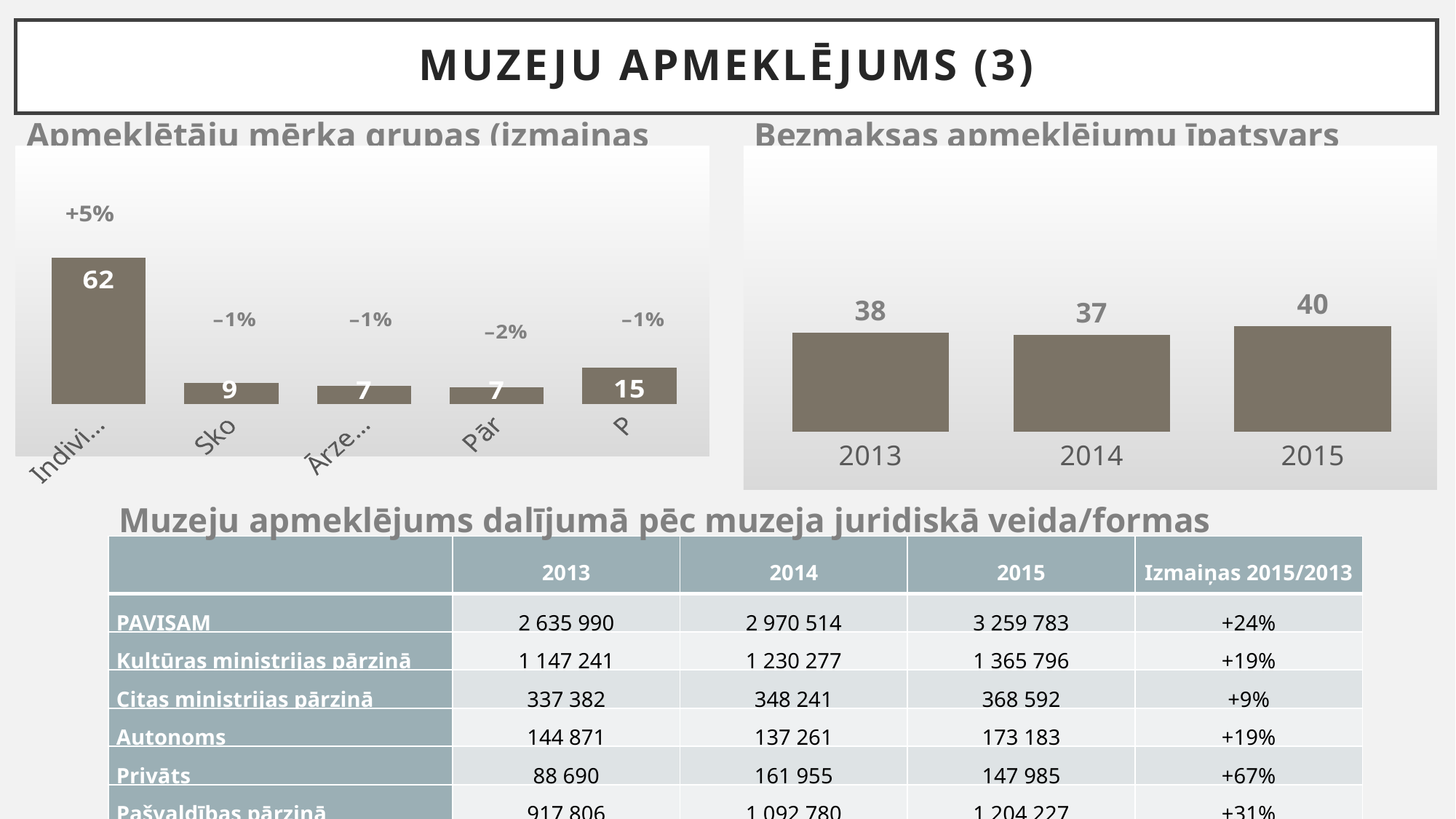
In the right-hand chart (Bezmaksas apmeklējumu īpatsvars), how many years are plotted? 3 In the right-hand chart (Bezmaksas apmeklējumu īpatsvars), what is the difference between the values for 2015 and 2013? 2 In the left-hand chart (Apmeklētāju mērķa grupas), what is the value of the rightmost bar? 15 In the right-hand chart (Bezmaksas apmeklējumu īpatsvars), which year has the lowest value? 2014 In the left-hand chart (Apmeklētāju mērķa grupas), what percentage change is printed above the tallest bar? +5% In the right-hand chart (Bezmaksas apmeklējumu īpatsvars), which year has the highest value? 2015 In the left-hand chart (Apmeklētāju mērķa grupas), what is the value of the tallest (leftmost) bar? 62 In the left-hand chart (Apmeklētāju mērķa grupas), how many bars are plotted? 5 What kind of chart is the right-hand chart (Bezmaksas apmeklējumu īpatsvars)? bar chart In the right-hand chart (Bezmaksas apmeklējumu īpatsvars), what is the value for 2013? 38 In the right-hand chart (Bezmaksas apmeklējumu īpatsvars), what is the value for 2015? 40 In the right-hand chart (Bezmaksas apmeklējumu īpatsvars), does the value rise or fall from 2014 to 2015? rise